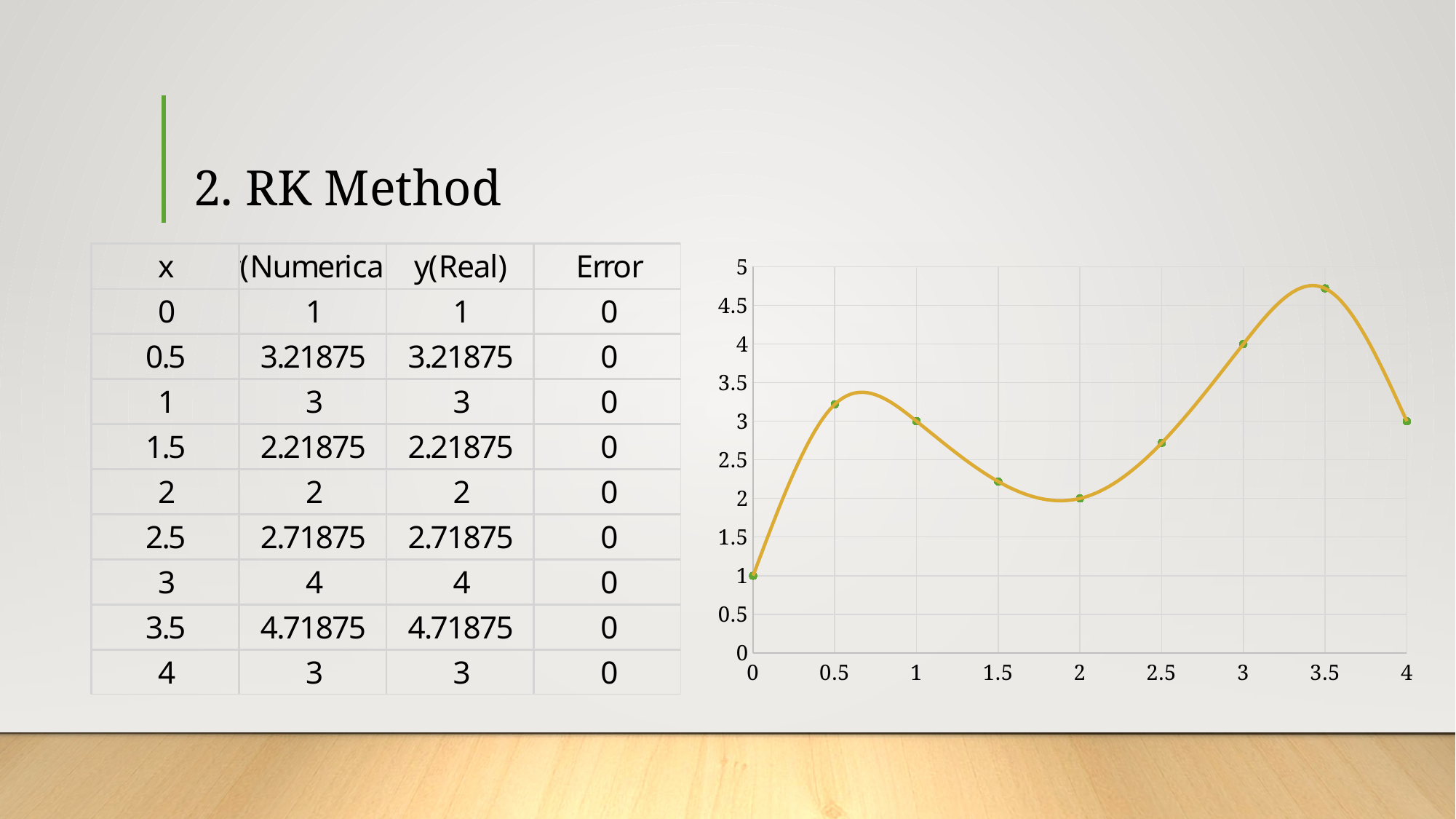
Is the y value of the point at x = 0.5 greater or less than 3? greater At which x value does the plotted curve have its lowest point? 0 Does the curve rise or fall between x = 3.5 and x = 4? fall What is the y value of the plotted point at x = 3? 4 Is the y value of the point at x = 1.5 greater or less than 2.5? less How many data points are plotted on the chart? 9 What kind of chart is shown on the right of the slide? line chart What is the y value of the plotted point at x = 2? 2 Which plotted point has the larger y value, the one at x = 1 or the one at x = 3? x = 3 What is the y value of the plotted point at x = 0? 1 At which x value does the plotted curve reach its highest point? 3.5 What is the difference between the y value at x = 3 and the y value at x = 1? 1